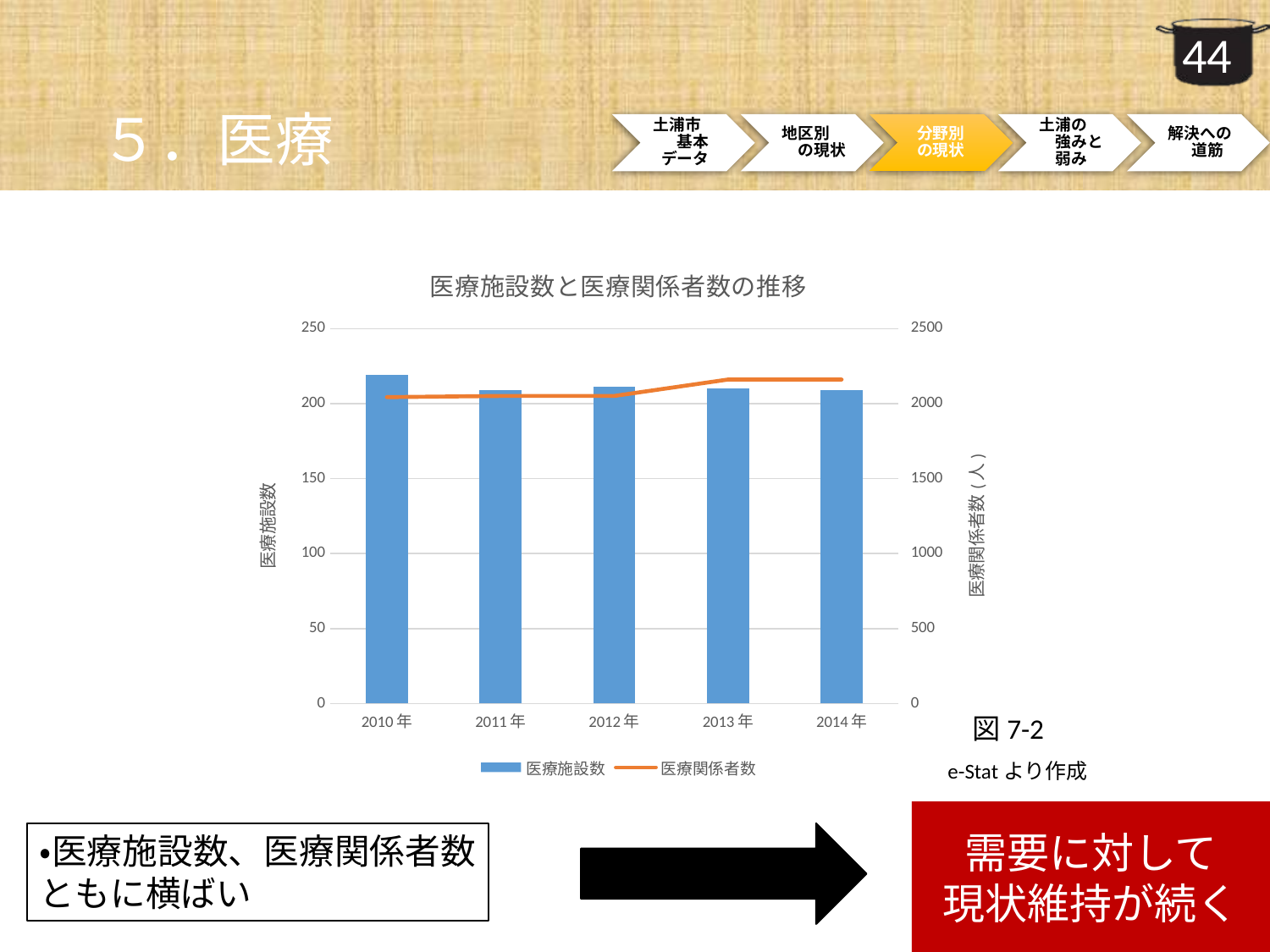
Is the value for 医療関係者数 in 2013年 greater or less than 2000? greater Which series is shown as an orange line? 医療関係者数 How many years are shown on the x axis? 5 Which year has the highest value for 医療施設数? 2010年 Is the value for 医療施設数 in 2010年 greater or less than 200? greater Is the value for 医療施設数 in 2014年 greater or less than 150? greater Which is larger, the 医療施設数 value for 2010年 or for 2011年? 2010年 Does the 医療関係者数 line rise or fall from 2012年 to 2013年? rise How many series does the legend list? 2 What is the title of the chart? 医療施設数と医療関係者数の推移 What kind of chart is this? Combined bar and line chart